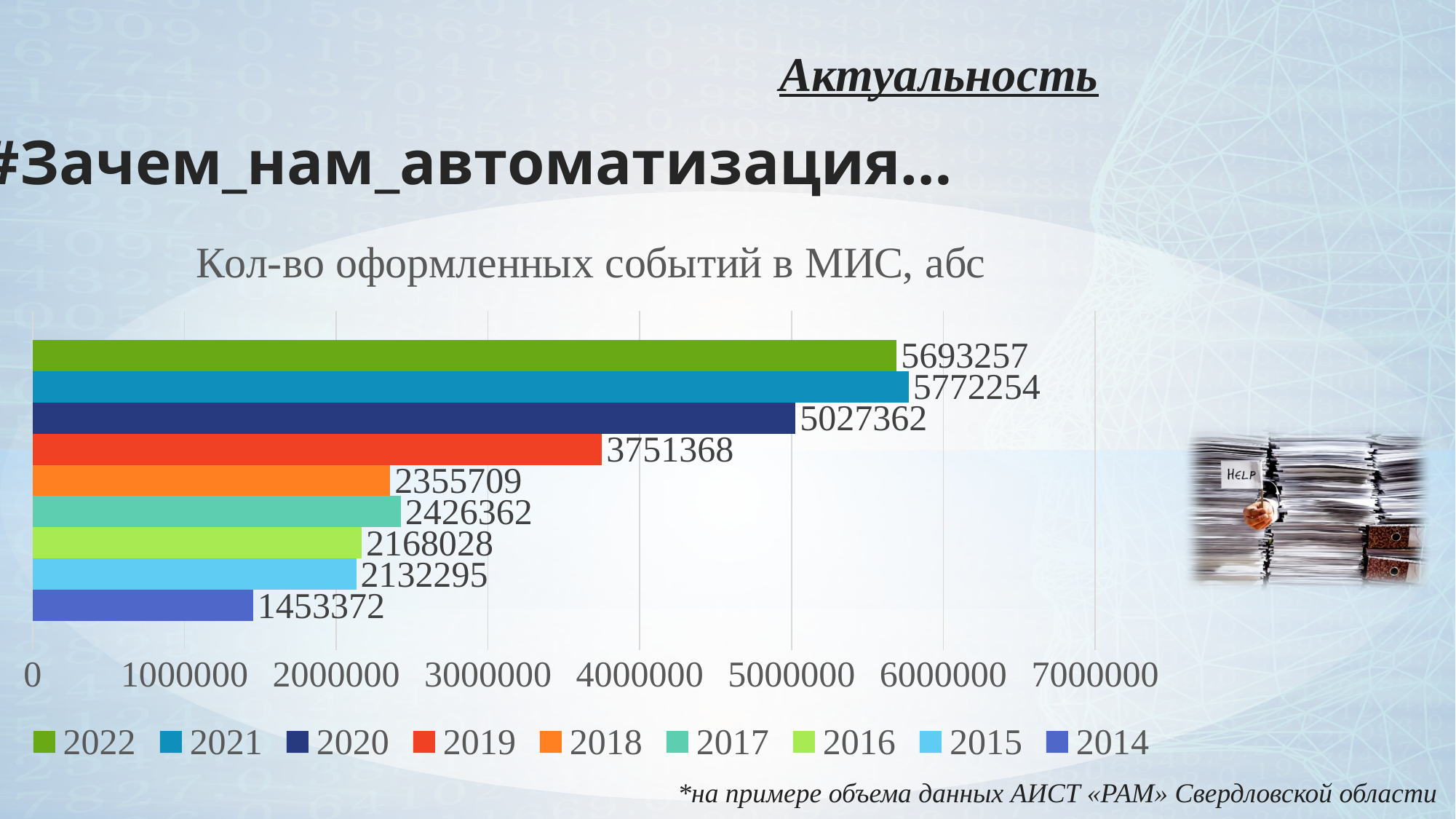
Is the value for 2020 greater or less than 5000000? greater How many entries does the legend list? 9 What kind of chart is shown on the slide? bar chart What is the difference between the values for 2020 and 2019? 1275994 What is the value for 2022 in the chart? 5693257 How many bars are shown in the chart? 9 Which is larger, the value for 2017 or the value for 2018? 2017 What is the value for 2019 in the chart? 3751368 Which year has the lowest value in the chart? 2014 Which year has the highest value in the chart? 2021 What is the difference between the values for 2021 and 2022? 78997 What is the value for 2014 in the chart? 1453372